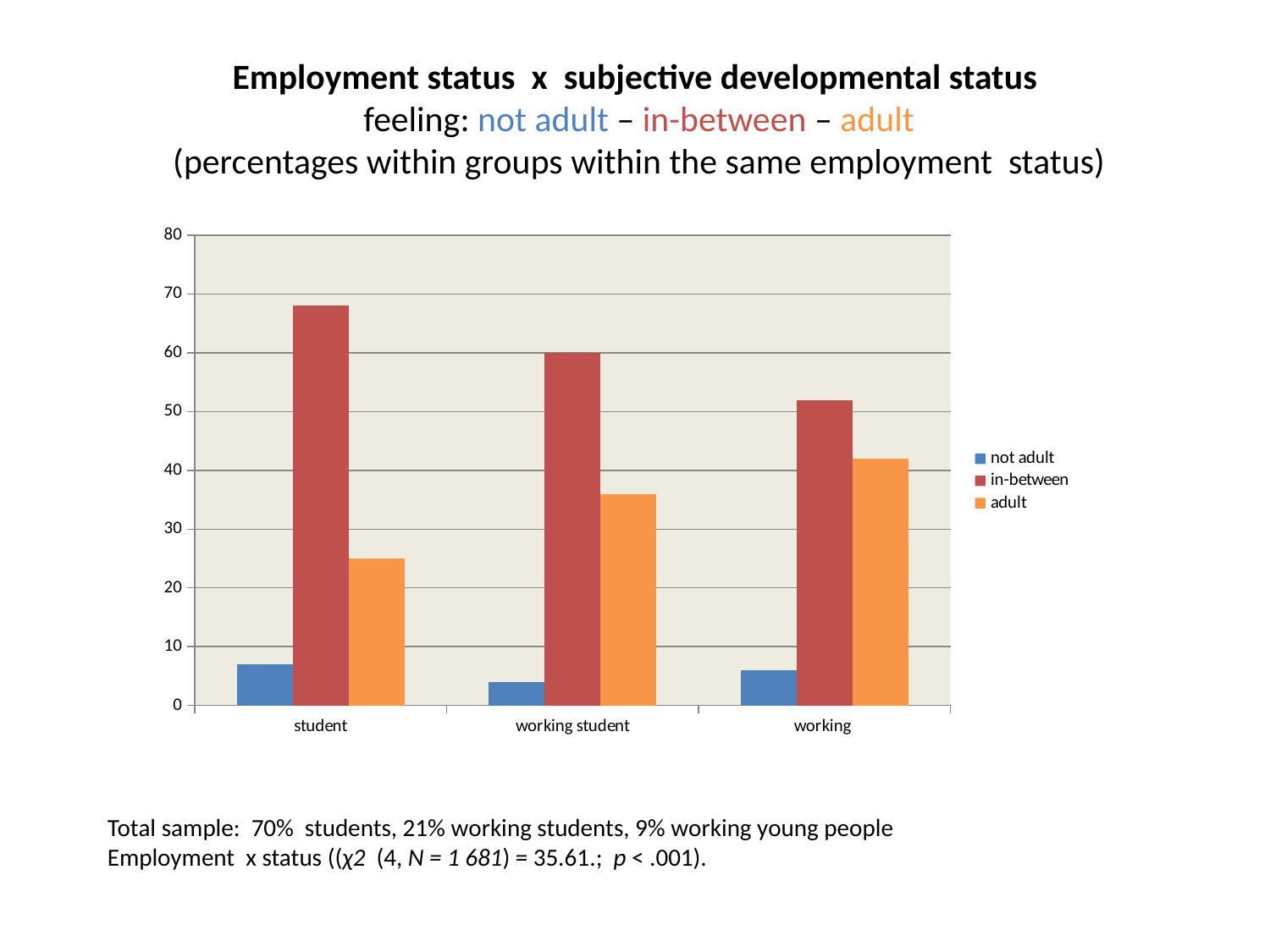
Which colour represents the 'adult' series in the legend? orange Do the 'adult' values rise or fall moving from student to working student to working? rise Is the 'in-between' value for student greater or less than 60? greater Which employment status group has the highest 'in-between' bar? student Is the 'not adult' value for working student greater or less than 10? less Is the 'adult' value for working greater or less than 40? greater What kind of chart is shown on the slide? bar chart Which employment status group has the highest 'adult' bar? working Which employment status group has the lowest 'adult' bar? student How many series does the legend list? 3 How many employment status categories are shown on the x axis? 3 For the working group, which is larger: the 'in-between' bar or the 'adult' bar? in-between